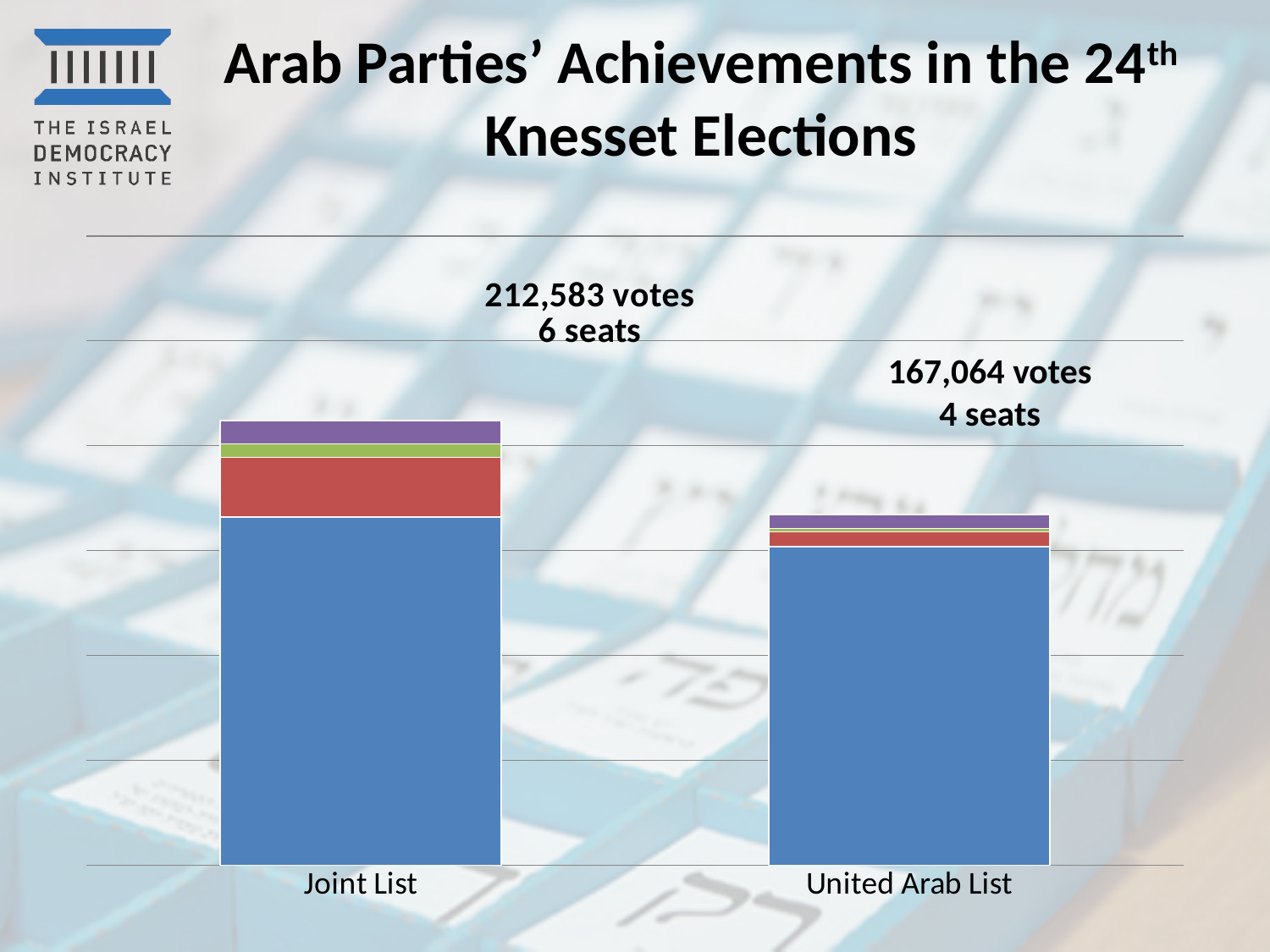
How many votes did the United Arab List receive according to the chart? 167,064 votes How many parties are shown on the x axis of the chart? 2 What is the difference in votes between the Joint List and the United Arab List? 45,519 votes Which party received the most votes? Joint List How many seats did the United Arab List win according to the chart? 4 seats Which party won the fewest seats? United Arab List How many more seats did the Joint List win than the United Arab List? 2 seats Which has the taller bar, Joint List or United Arab List? Joint List How many votes did the Joint List receive according to the chart? 212,583 votes How many seats did the Joint List win according to the chart? 6 seats What is the title of the slide? Arab Parties' Achievements in the 24th Knesset Elections What kind of chart is shown on the slide? Stacked bar chart